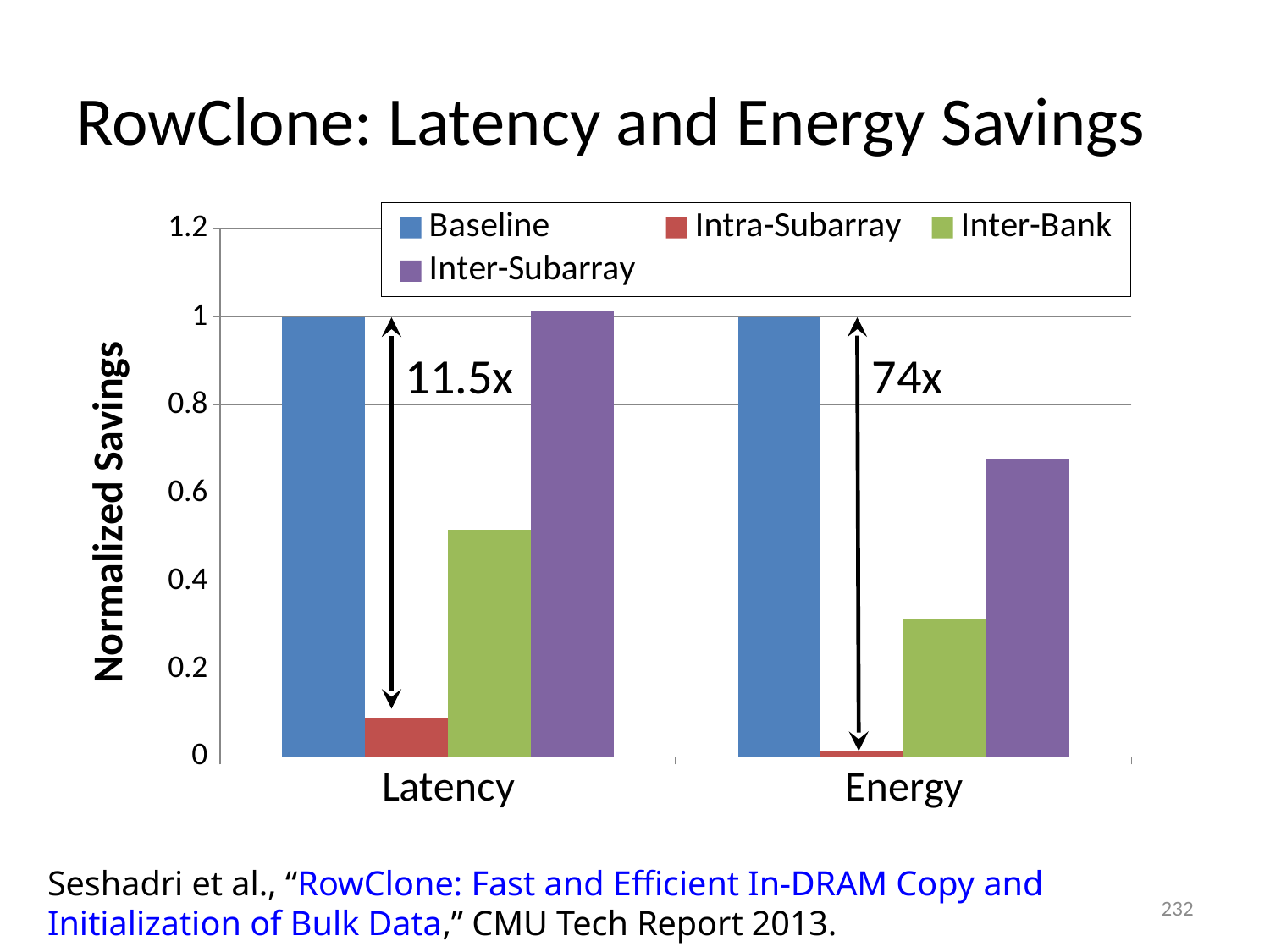
Is the Inter-Bank value for Latency greater or less than 0.4? greater Which series has the lowest value for Energy? Intra-Subarray What is the Baseline value for Latency? 1 Which series has the highest value for Energy? Baseline Which is larger: the Inter-Bank value for Latency or the Inter-Bank value for Energy? Inter-Bank value for Latency How many series does the legend list? 4 What improvement factor is annotated between Baseline and Intra-Subarray for Energy? 74x What kind of chart is shown on the slide? bar chart How many categories are shown on the x axis? 2 What is the Baseline value for Energy? 1 Which series has the lowest value for Latency? Intra-Subarray Is the Inter-Subarray value for Energy greater or less than 0.8? less